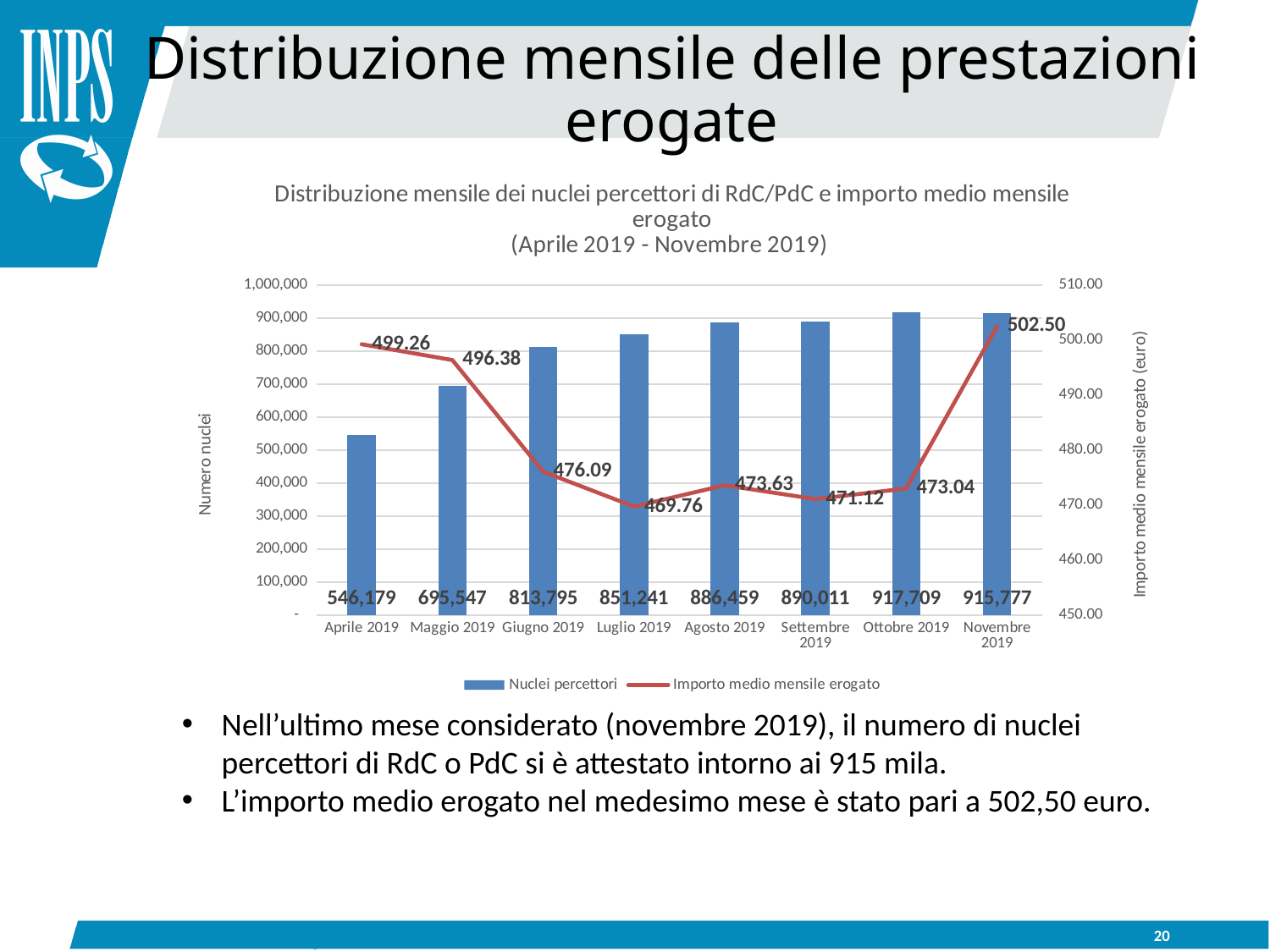
Which month has the highest number of nuclei percettori? Ottobre 2019 By how much does the importo medio mensile erogato in Novembre 2019 exceed that of Ottobre 2019? 29.46 How many nuclei percettori are shown for Aprile 2019? 546,179 What is the importo medio mensile erogato for Novembre 2019? 502.50 Which month has the lowest importo medio mensile erogato? Luglio 2019 What kind of chart is this? Combined bar and line chart How many months are shown on the x axis? 8 How many series does the legend list? 2 What is the importo medio mensile erogato for Giugno 2019? 476.09 What is the difference in nuclei percettori between Novembre 2019 and Aprile 2019? 369,598 Which month has the lowest number of nuclei percettori? Aprile 2019 Which is larger, the number of nuclei percettori in Maggio 2019 or in Giugno 2019? Giugno 2019